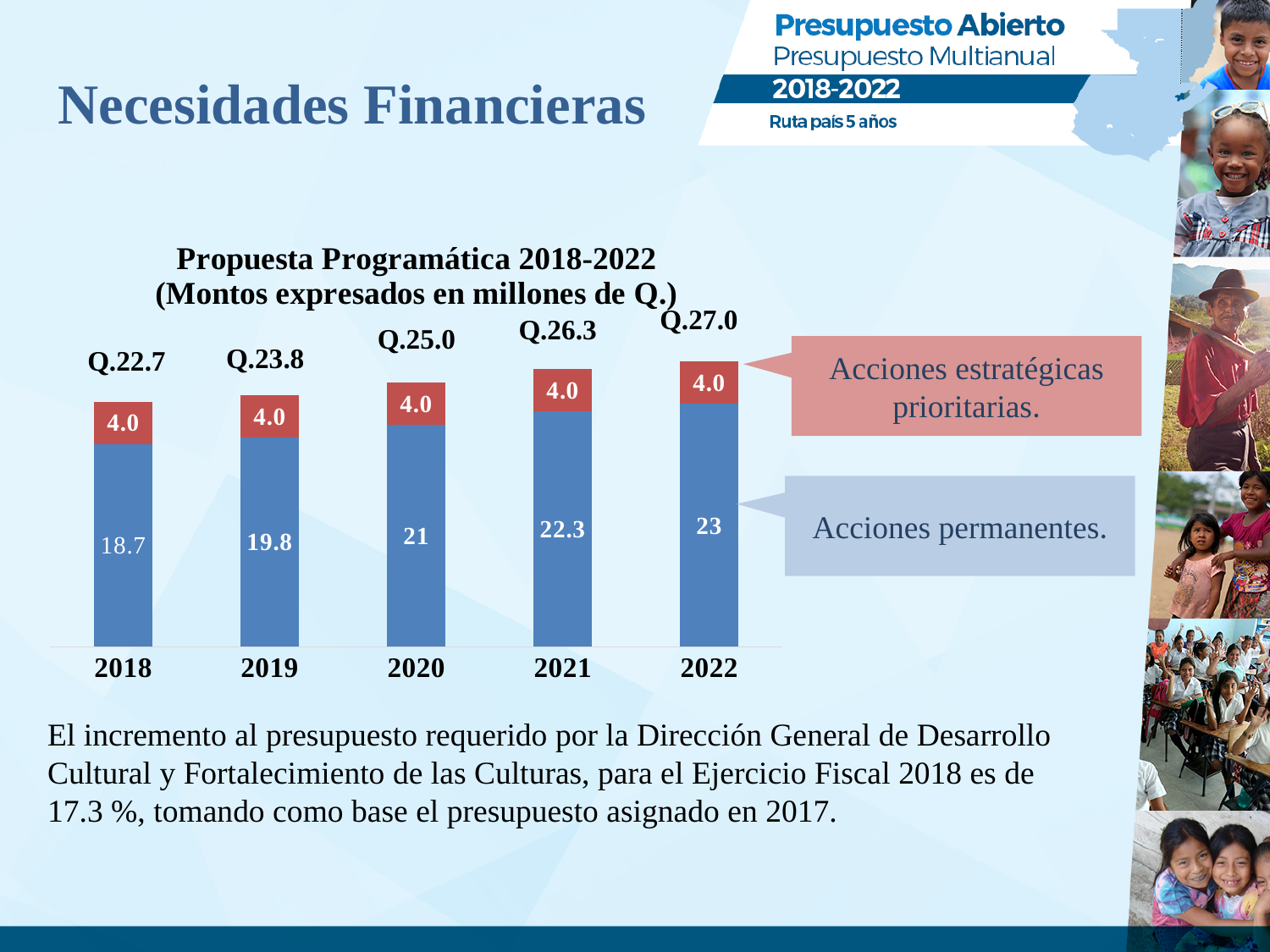
Which year has the lowest value for Acciones permanentes? 2018 What is the value of Acciones permanentes for 2021? 22.3 What is the total shown above the bar for 2022? Q.27.0 What is the value of Acciones permanentes for 2018? 18.7 How many years are shown on the x axis of the chart? 5 What is the difference between the Acciones permanentes values for 2022 and 2018? 4.3 What is the title of the chart? Propuesta Programática 2018-2022 (Montos expresados en millones de Q.) Which year has the highest total in the chart? 2022 What kind of chart is shown on the slide? Stacked bar chart Do the bar totals rise or fall from 2018 to 2022? Rise What is the value of Acciones estratégicas prioritarias for 2020? 4.0 What is the total shown above the bar for 2019? Q.23.8